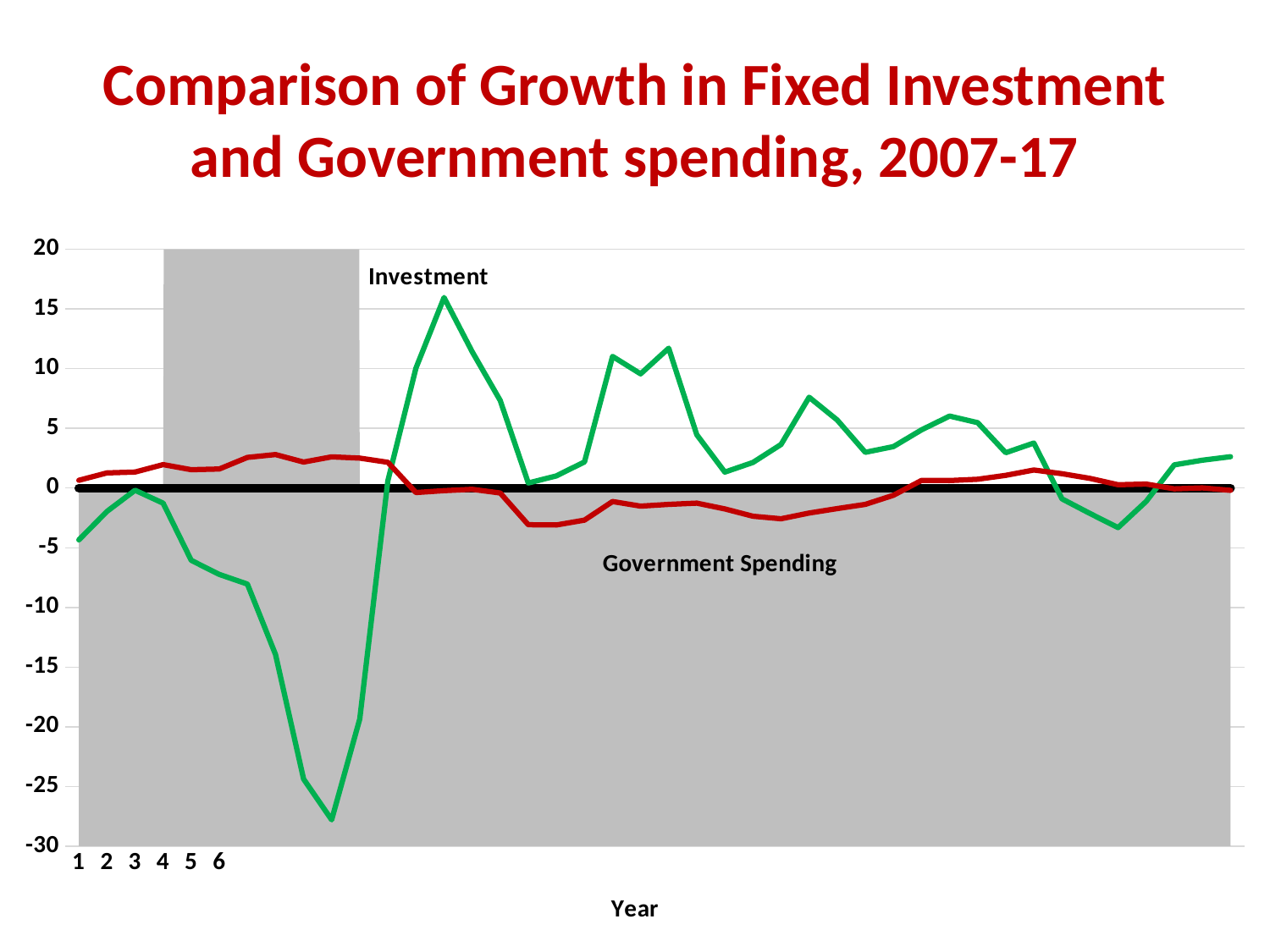
Which series reaches the highest value on the chart, Investment or Government Spending? Investment What kind of chart is shown on the slide? line chart What colour is the Investment line? green At year 5, which series has the larger value, Investment or Government Spending? Government Spending What is the title of the chart on the slide? Comparison of Growth in Fixed Investment and Government spending, 2007-17 Is the lowest value of the Investment line greater or less than -25? less How many data series are plotted on the chart? 2 Is the highest value of the Investment line greater or less than 15? greater Is the value of the Government Spending line at year 6 greater or less than 0? greater Which series reaches the lowest value on the chart, Investment or Government Spending? Investment